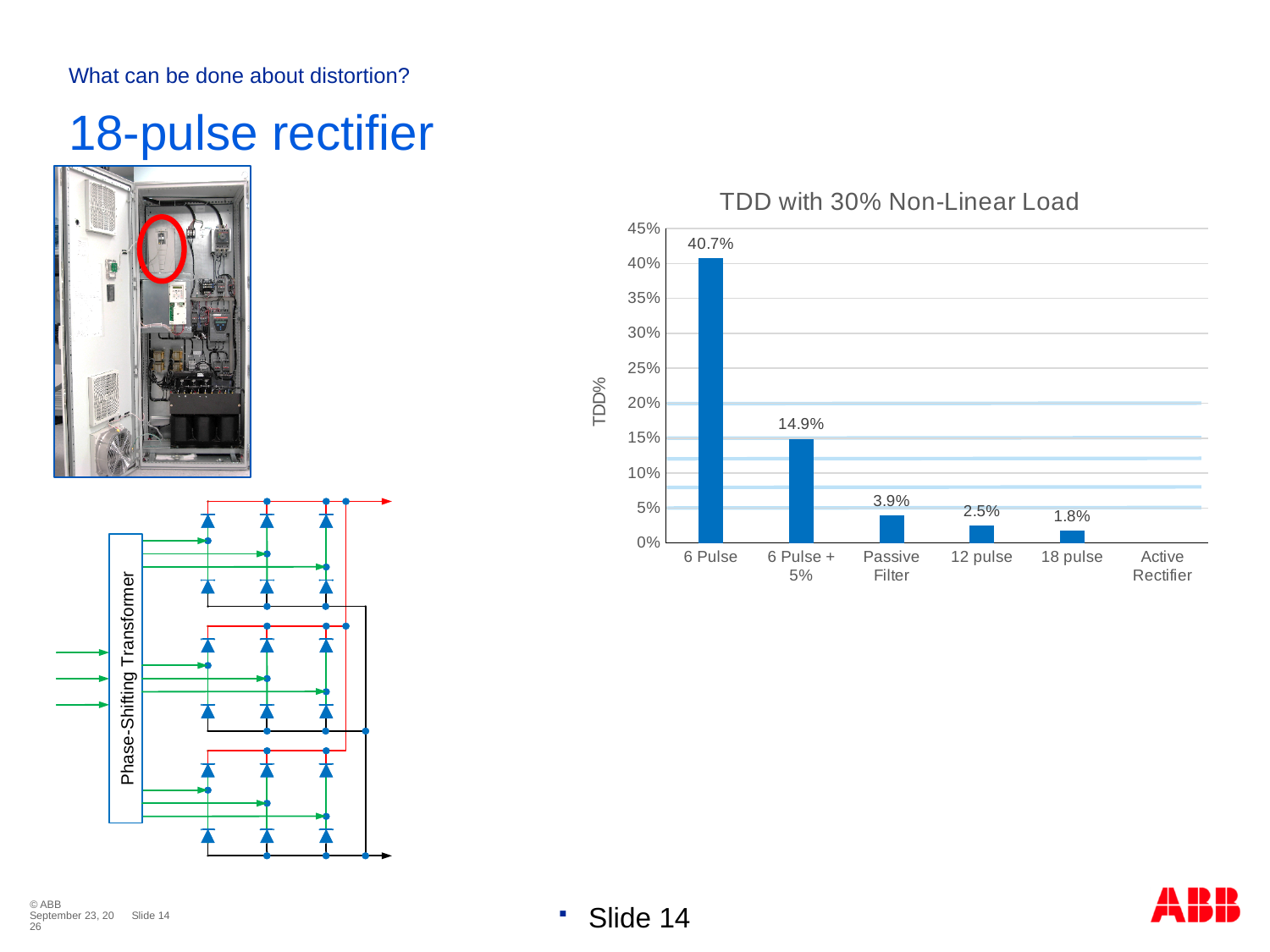
What is the title of the chart on the slide? TDD with 30% Non-Linear Load What is the difference between the TDD values for 6 Pulse and 6 Pulse + 5%? 25.8% What is the TDD value for Passive Filter? 3.9% What is the TDD value for 12 pulse? 2.5% What is the TDD value for 6 Pulse in the chart? 40.7% Which has a higher TDD value, Passive Filter or 12 pulse? Passive Filter Is the TDD value for 6 Pulse greater or less than 40%? greater How many categories are shown on the x axis of the chart? 6 What is the difference between the TDD values for 12 pulse and 18 pulse? 0.7% What is the TDD value for 6 Pulse + 5%? 14.9% Which category has the highest TDD value in the chart? 6 Pulse What is the TDD value for 18 pulse? 1.8%